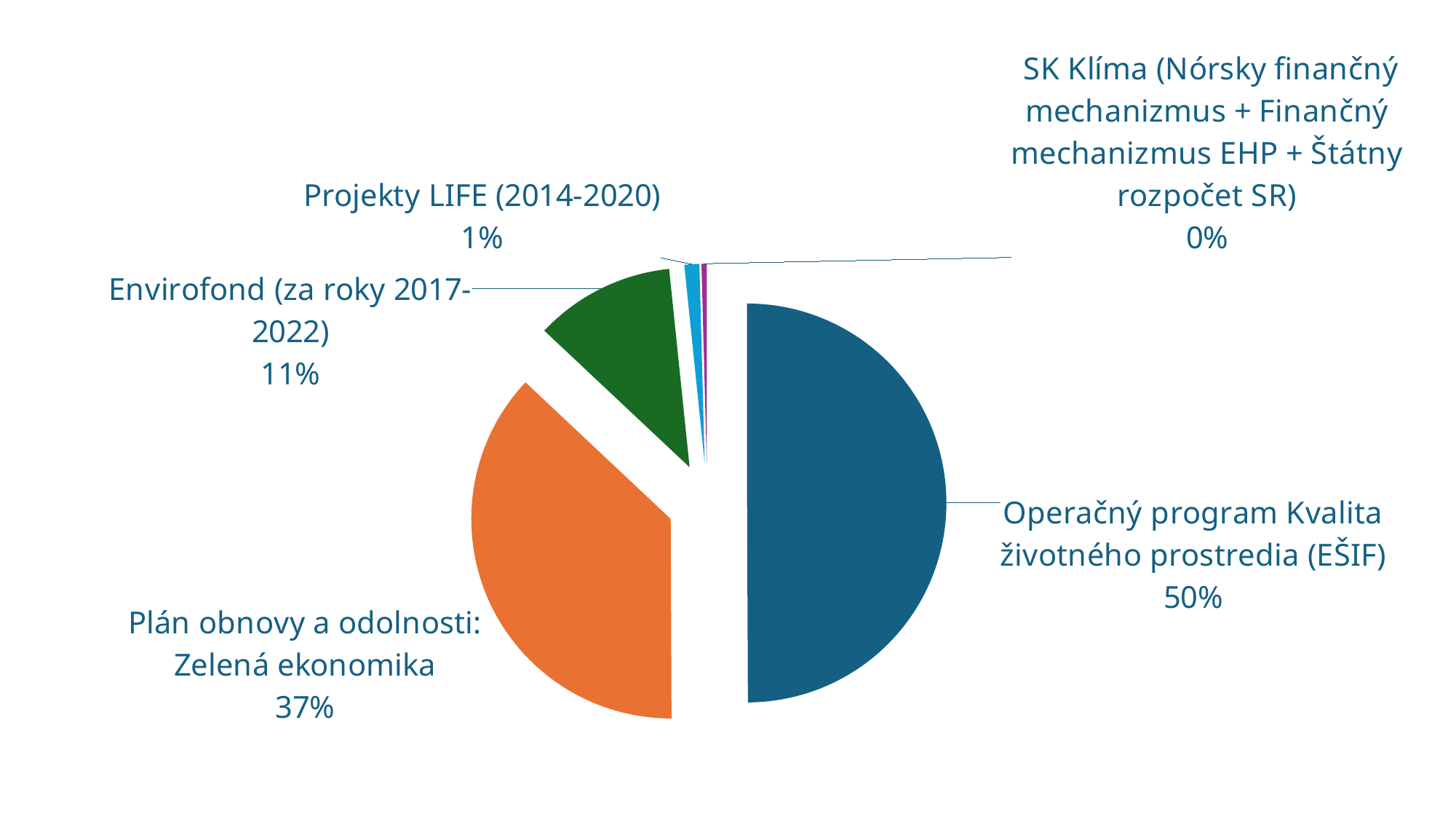
What kind of chart is shown on the slide? Pie chart What share of the pie does Plán obnovy a odolnosti: Zelená ekonomika have? 37% What share of the pie does Projekty LIFE (2014-2020) have? 1% How many slices does the pie chart have? 5 What share of the pie does Envirofond (za roky 2017-2022) have? 11% What is the difference in percentage points between Operačný program Kvalita životného prostredia (EŠIF) and Plán obnovy a odolnosti: Zelená ekonomika? 13% Which category has the largest slice of the pie? Operačný program Kvalita životného prostredia (EŠIF) Which category has the smallest slice of the pie? SK Klíma (Nórsky finančný mechanizmus + Finančný mechanizmus EHP + Štátny rozpočet SR) Which is larger, the share for Envirofond (za roky 2017-2022) or the share for Projekty LIFE (2014-2020)? Envirofond (za roky 2017-2022) What colour is the slice for Plán obnovy a odolnosti: Zelená ekonomika? Orange